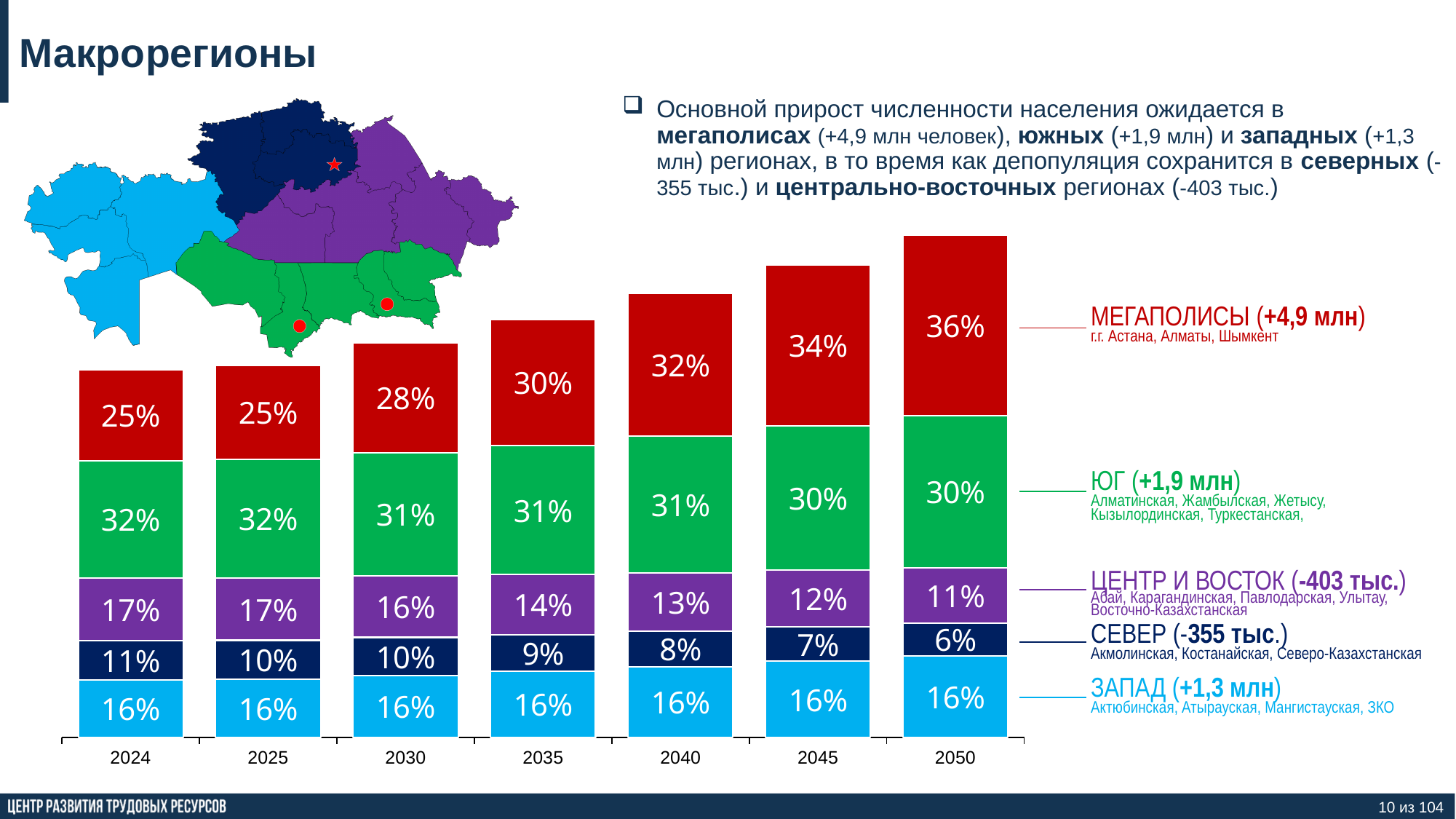
How many series (macroregions) does the chart show? 5 In which year is the МЕГАПОЛИСЫ share the highest? 2050 What share does ЦЕНТР И ВОСТОК have in 2040? 13% In which year is the СЕВЕР share the lowest? 2050 What share does МЕГАПОЛИСЫ have in 2050? 36% Does the ЦЕНТР И ВОСТОК share rise or fall from 2024 to 2050? Fall What share does ЮГ have in 2030? 31% Which is larger in 2045: the ЮГ share or the МЕГАПОЛИСЫ share? МЕГАПОЛИСЫ By how many percentage points does the МЕГАПОЛИСЫ share in 2050 exceed its share in 2024? 11 What share does СЕВЕР have in 2024? 11% What kind of chart is shown on the slide? Stacked bar chart How many years are shown on the x axis? 7